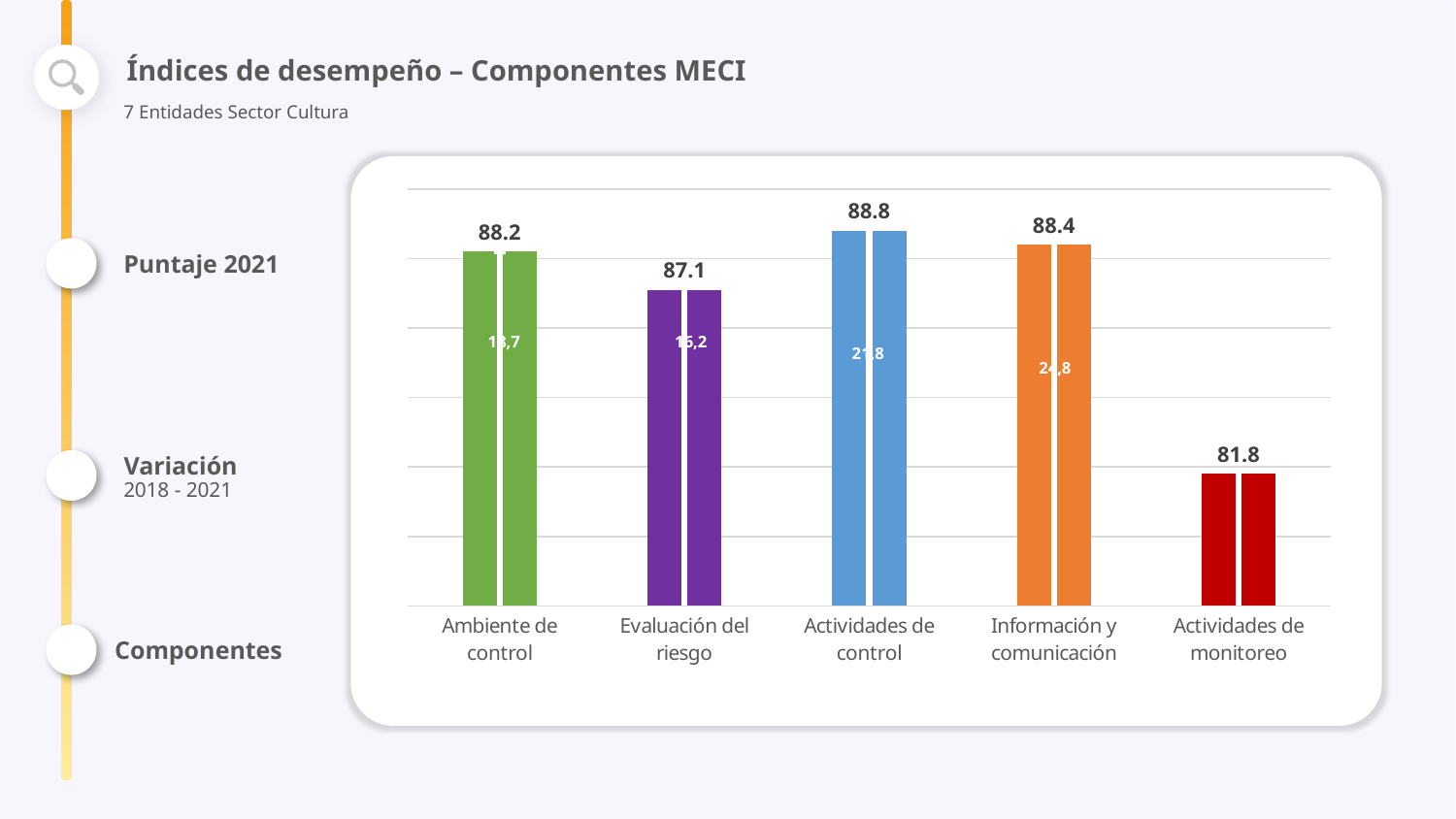
What is the 2021 score shown for Evaluación del riesgo? 87.1 What is the 2021 score shown for Información y comunicación? 88.4 Which has a higher 2021 score, Información y comunicación or Evaluación del riesgo? Información y comunicación What is the 2021 score shown for Ambiente de control? 88.2 What is the difference between the 2021 scores of Ambiente de control and Evaluación del riesgo? 1.1 What is the 2021 score shown for Actividades de control? 88.8 Which component has the highest 2021 score? Actividades de control How many components are shown on the chart? 5 What is the difference between the 2021 scores of Actividades de control and Actividades de monitoreo? 7.0 Which component has the lowest 2021 score? Actividades de monitoreo What is the 2021 score shown for Actividades de monitoreo? 81.8 What type of chart is shown on the slide? Bar chart